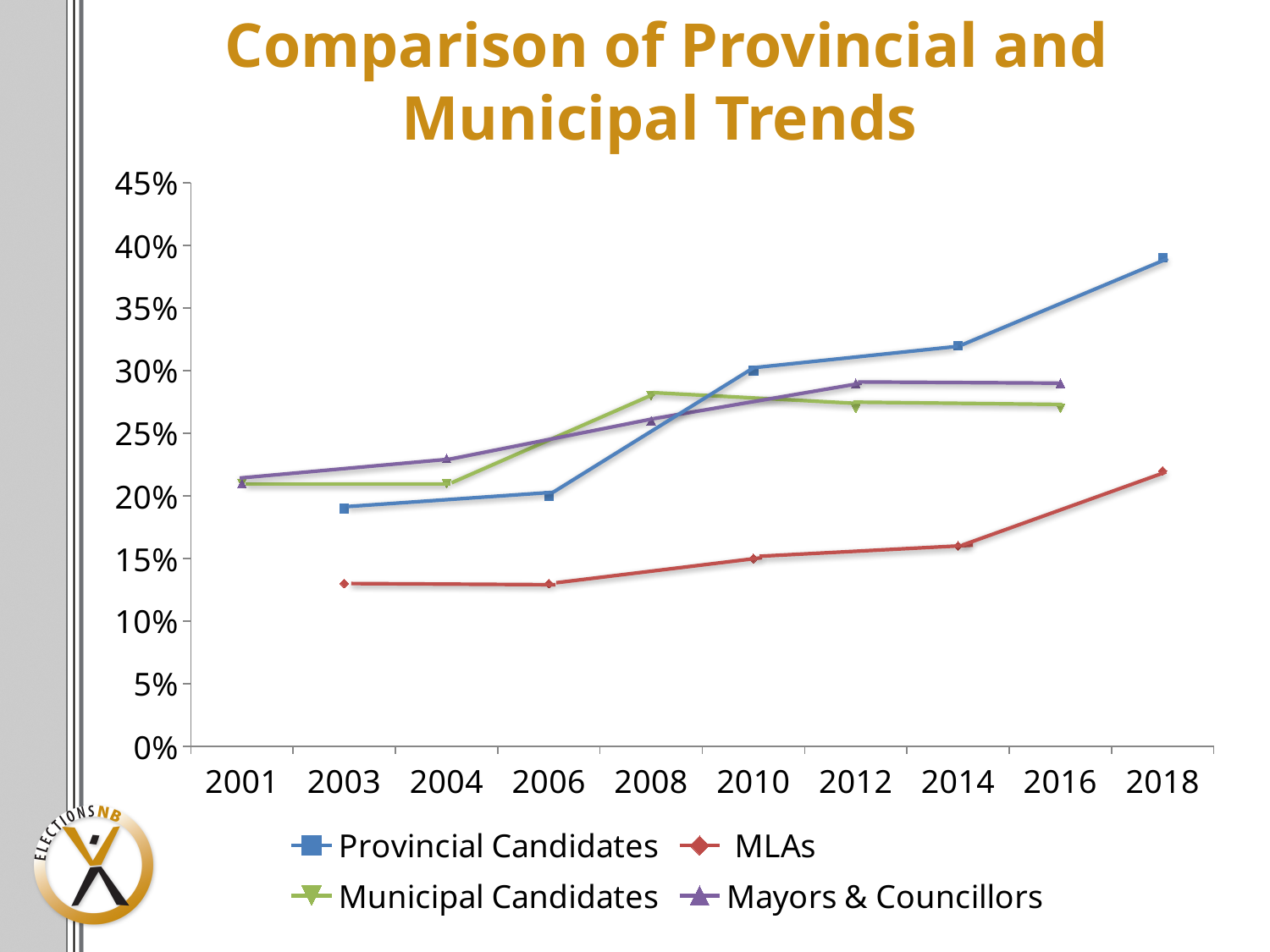
Which series has the lowest value in 2018? MLAs Is the value for Mayors & Councillors in 2012 greater or less than 25%? greater What is the value for Provincial Candidates in 2010? 30% What is the value for Provincial Candidates in 2006? 20% How many series does the legend list? 4 How many years are shown on the x axis? 10 Is the value for MLAs in 2003 greater or less than 15%? less Is the value for Provincial Candidates in 2018 greater or less than 35%? greater What is the value for MLAs in 2010? 15% What kind of chart is shown on the slide? line chart Do the values for Provincial Candidates rise or fall from 2003 to 2018? rise